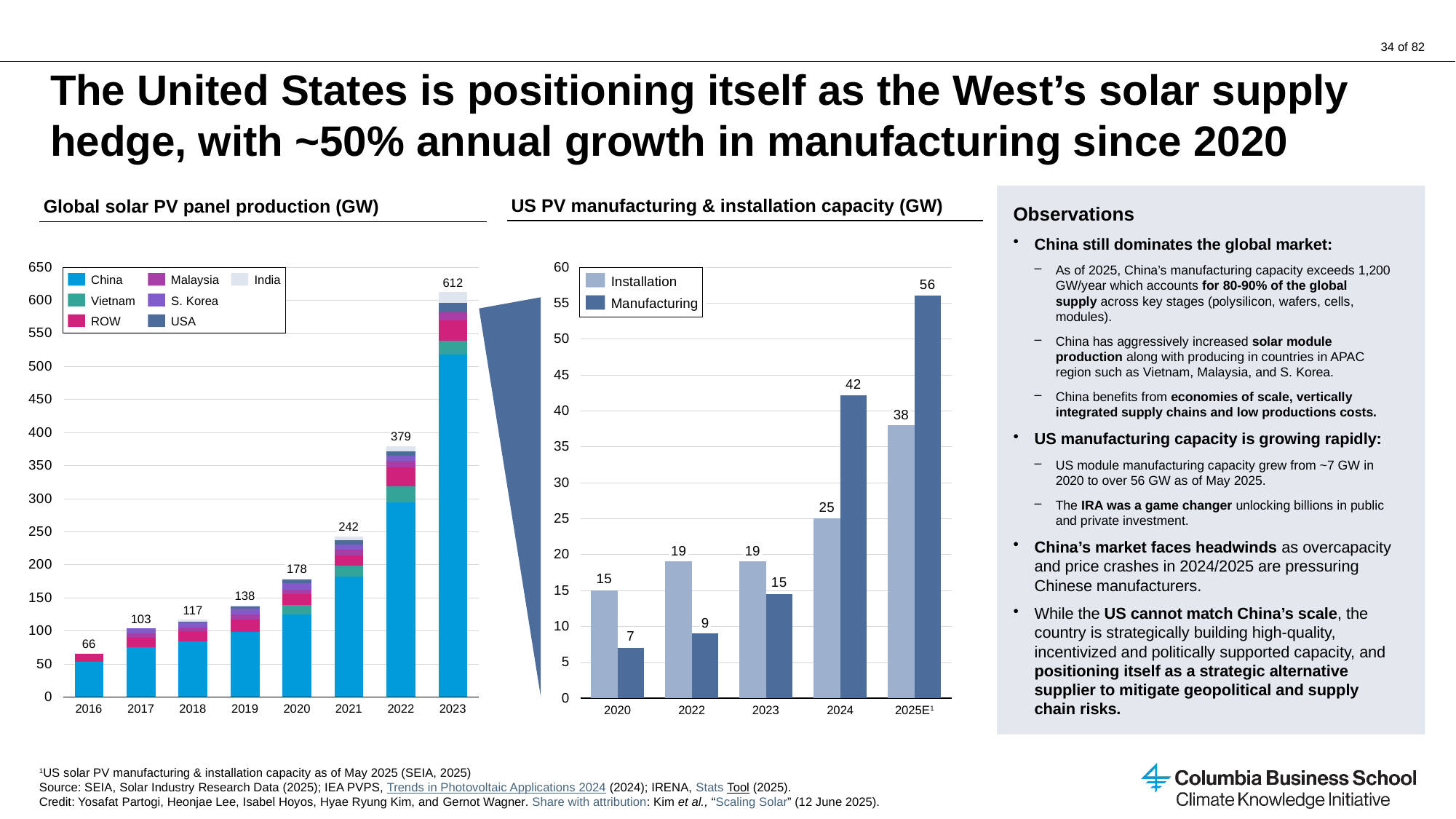
In the 'Global solar PV panel production (GW)' chart, which year has the lowest total production? 2016 In the 'Global solar PV panel production (GW)' chart, what is the difference between the 2023 total and the 2022 total? 233 In the 'US PV manufacturing & installation capacity (GW)' chart, how many years are shown on the x axis? 5 In the 'US PV manufacturing & installation capacity (GW)' chart, what is the difference between Manufacturing in 2025E and Manufacturing in 2020? 49 In the 'Global solar PV panel production (GW)' chart, how many series does the legend list? 7 In the 'Global solar PV panel production (GW)' chart, is the China segment for 2023 greater or less than 500? greater In the 'Global solar PV panel production (GW)' chart, what is the total production for 2023? 612 In the 'US PV manufacturing & installation capacity (GW)' chart, what is the Installation value for 2025E? 38 In the 'US PV manufacturing & installation capacity (GW)' chart, what is the Manufacturing value for 2024? 42 In the 'US PV manufacturing & installation capacity (GW)' chart, which is larger in 2022, Installation or Manufacturing? Installation In the 'Global solar PV panel production (GW)' chart, what is the total production for 2020? 178 In the 'Global solar PV panel production (GW)' chart, do the total values rise or fall from 2016 to 2023? rise